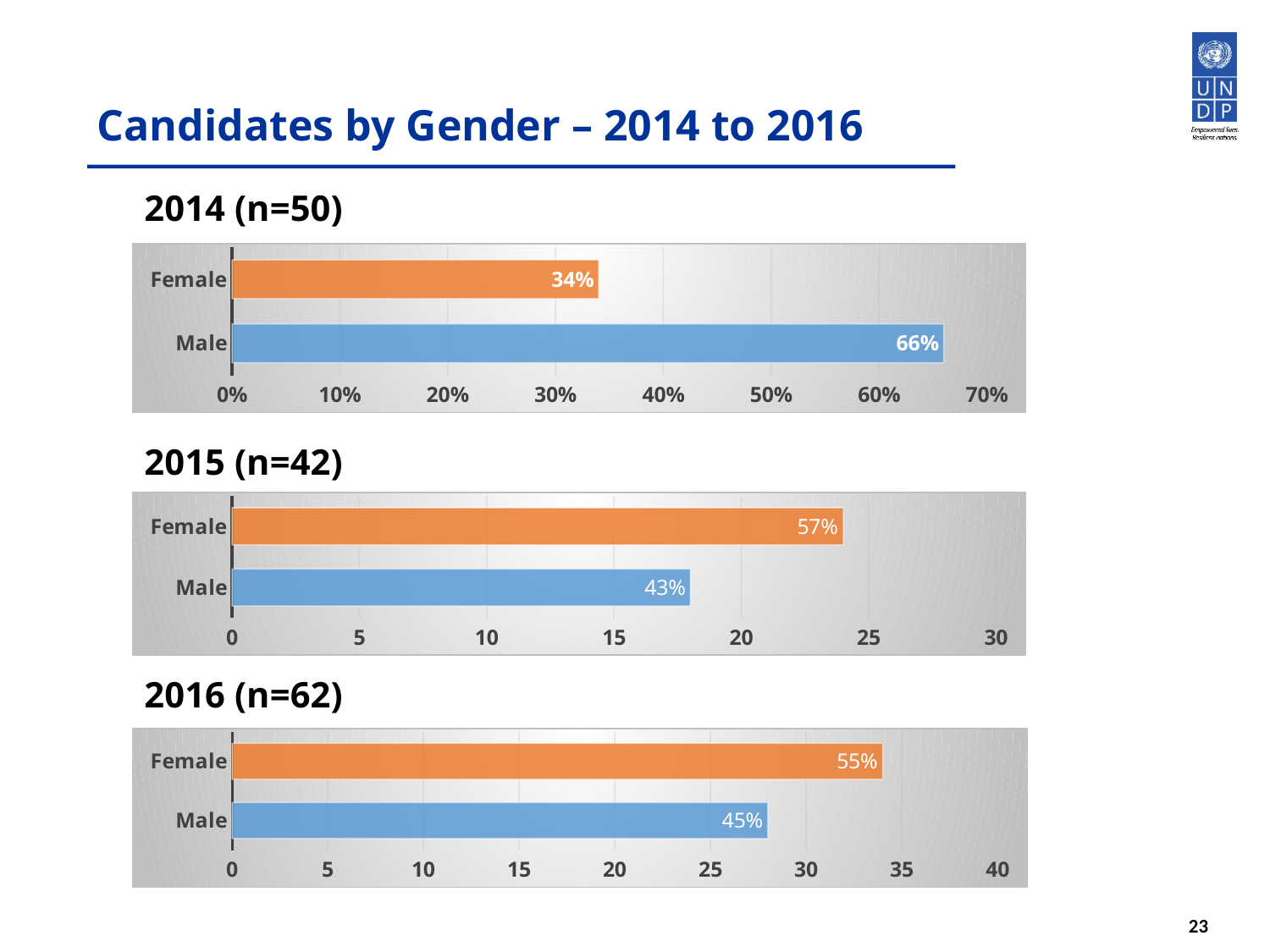
In the 2016 (n=62) chart, which category has the lowest value? Male In the 2016 (n=62) chart, which is larger, the Female value or the Male value? Female How many categories are shown in the 2016 (n=62) chart? 2 In the 2014 (n=50) chart, which category has the highest value? Male In the 2015 (n=42) chart, what is the difference between the Female and Male values? 14% In the 2015 (n=42) chart, is the Female bar greater or less than 20 on the axis? greater In the 2014 (n=50) chart, what is the difference between the Male and Female values? 32% What type of chart is the 2014 (n=50) chart? Bar chart In the 2014 (n=50) chart, what is the value for Male? 66% In the 2015 (n=42) chart, what is the value for Female? 57% In the 2014 (n=50) chart, what is the value for Female? 34% In the 2016 (n=62) chart, what is the value for Male? 45%